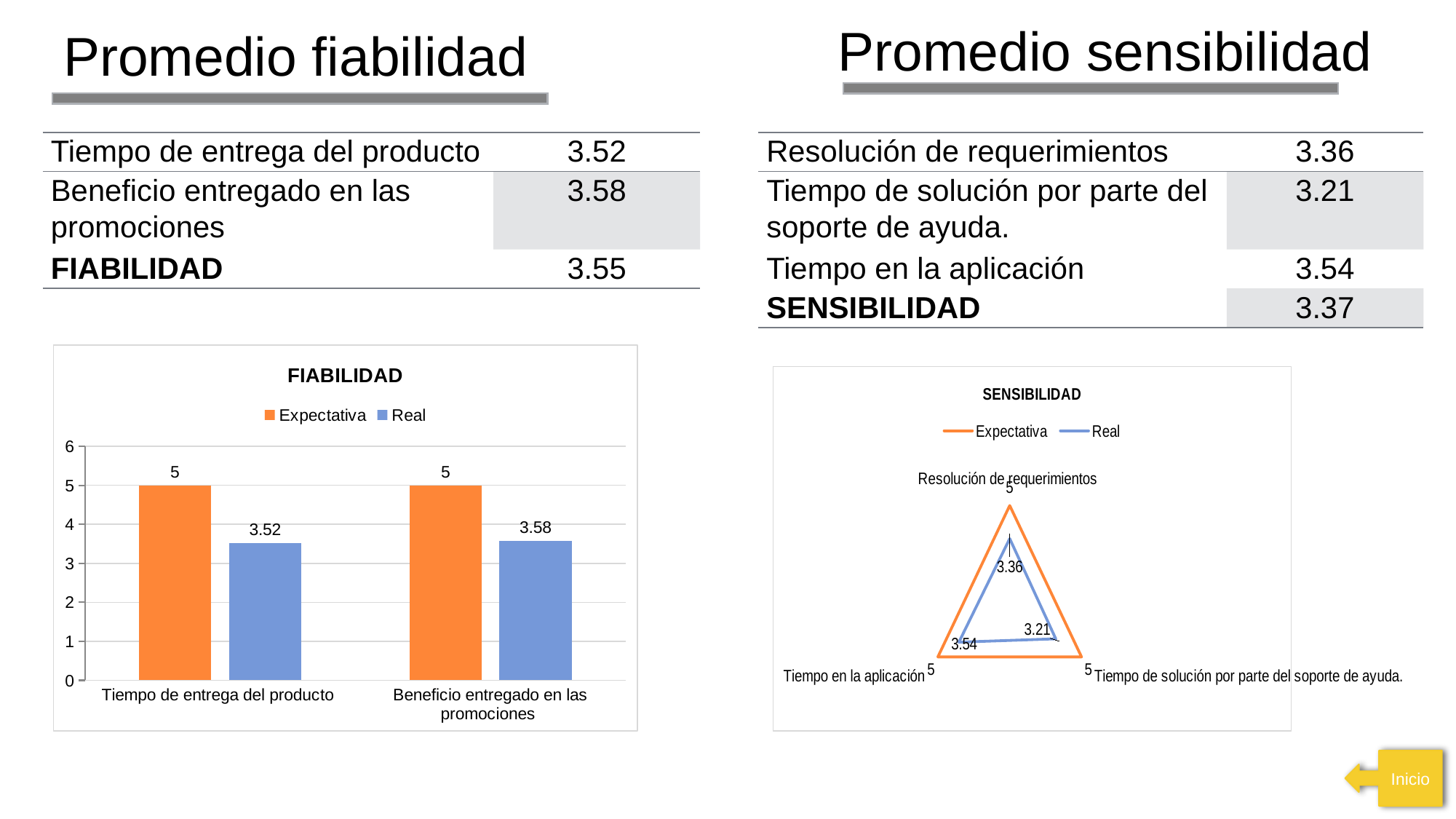
In the SENSIBILIDAD chart, which category has the lowest Real value? Tiempo de solución por parte del soporte de ayuda In the FIABILIDAD chart, what is the difference between the Expectativa and Real values for Beneficio entregado en las promociones? 1.42 In the FIABILIDAD chart, how many series does the legend list? 2 What kind of chart is the FIABILIDAD chart? Bar chart In the FIABILIDAD chart, which category has the higher Real value? Beneficio entregado en las promociones In the FIABILIDAD chart, what is the Real value for Tiempo de entrega del producto? 3.52 In the FIABILIDAD chart, what is the Expectativa value for Tiempo de entrega del producto? 5 In the SENSIBILIDAD chart, what is the Real value for Tiempo de solución por parte del soporte de ayuda? 3.21 What kind of chart is the SENSIBILIDAD chart? Radar chart In the SENSIBILIDAD chart, what is the Real value for Resolución de requerimientos? 3.36 In the FIABILIDAD chart, what is the Real value for Beneficio entregado en las promociones? 3.58 In the FIABILIDAD chart, how many categories are shown on the x axis? 2